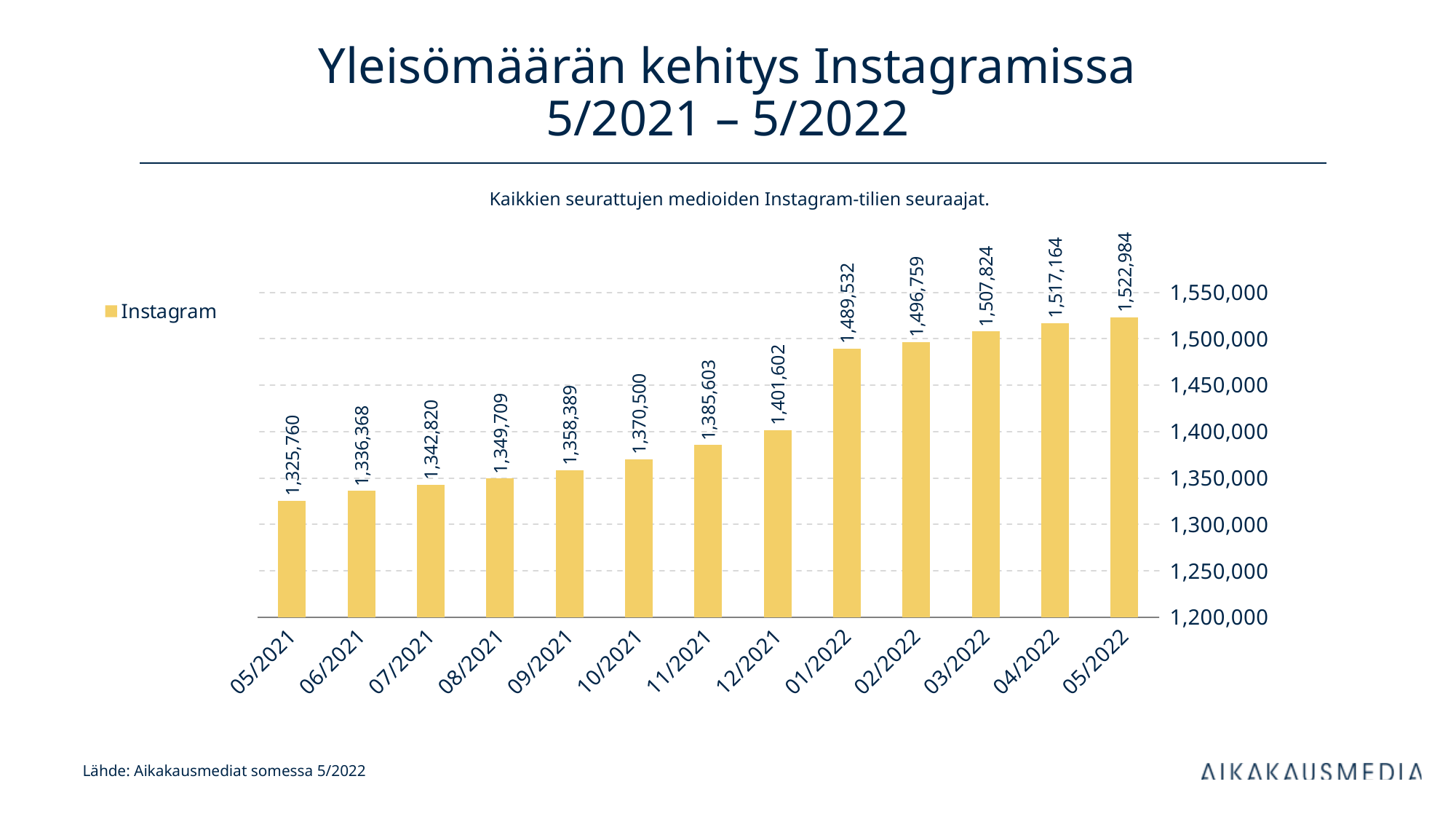
How many months are shown on the x axis? 13 What is the Instagram follower count for 05/2021? 1,325,760 What is the value shown for 01/2022? 1,489,532 Which month has the highest value? 05/2022 Which month has the lowest value? 05/2021 What is the difference between the values for 05/2022 and 05/2021? 197,224 What is the difference between the values for 01/2022 and 12/2021? 87,930 What kind of chart is shown on the slide? bar chart Is the value for 11/2021 greater or less than 1,400,000? less Do the values rise or fall from 05/2021 to 05/2022? rise What is the value shown for 10/2021? 1,370,500 Which is larger, the value for 12/2021 or the value for 02/2022? 02/2022